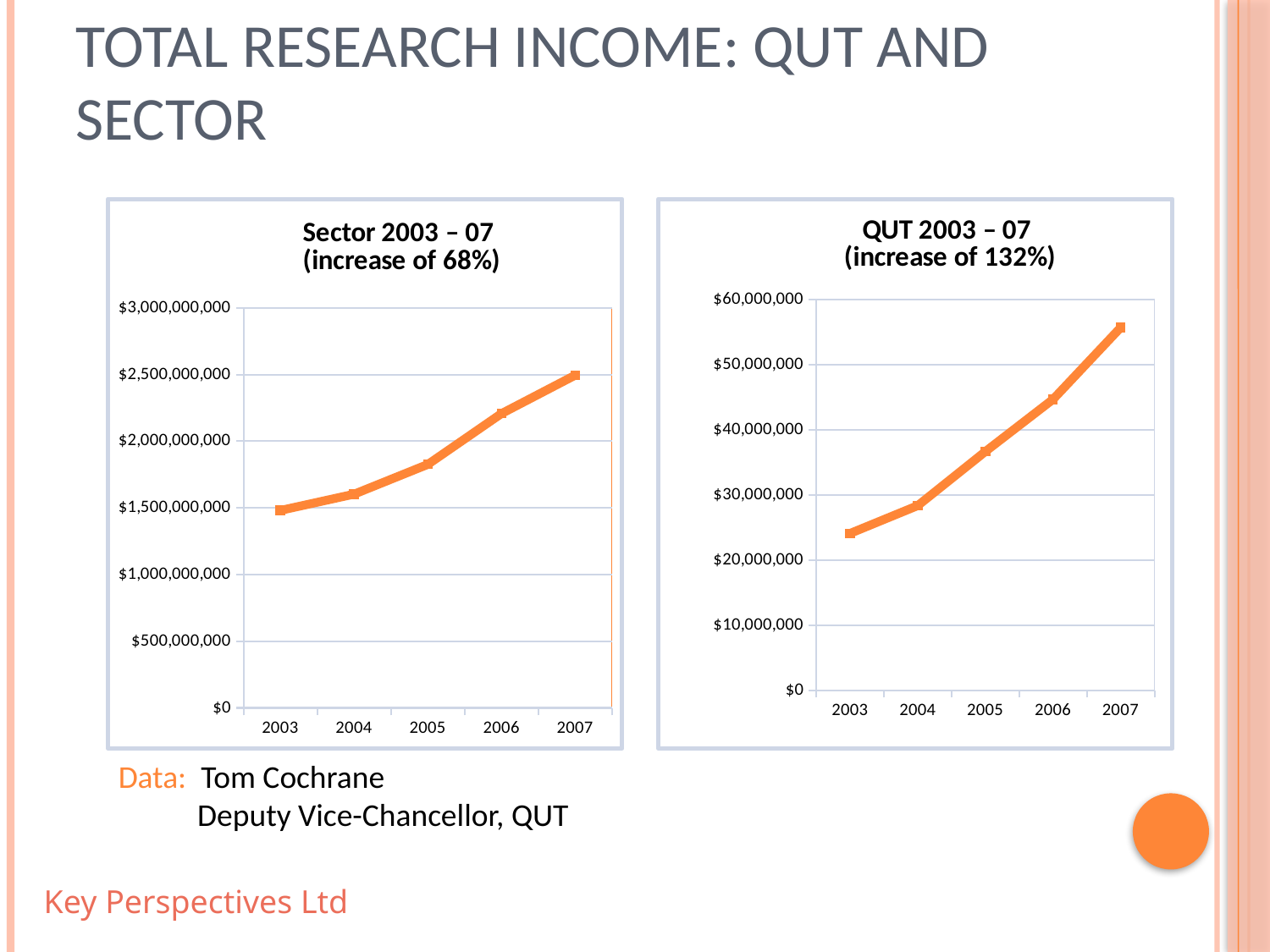
In the 'QUT 2003 – 07' chart, is the value for 2007 greater or less than $50,000,000? greater In the 'QUT 2003 – 07' chart, how many years are plotted on the x axis? 5 In the 'Sector 2003 – 07' chart, which year has the lowest value? 2003 What percentage increase is stated in the title of the 'Sector 2003 – 07' chart? 68% In the 'Sector 2003 – 07' chart, is the value for 2006 greater or less than $2,000,000,000? greater In the 'Sector 2003 – 07' chart, do the values rise or fall from 2003 to 2007? rise In the 'QUT 2003 – 07' chart, which year has the highest value? 2007 In the 'QUT 2003 – 07' chart, is the value for 2005 greater or less than $40,000,000? less What percentage increase is stated in the title of the 'QUT 2003 – 07' chart? 132% In the 'QUT 2003 – 07' chart, which is larger, the value for 2004 or the value for 2006? 2006 What kind of chart is the 'Sector 2003 – 07' chart? line chart